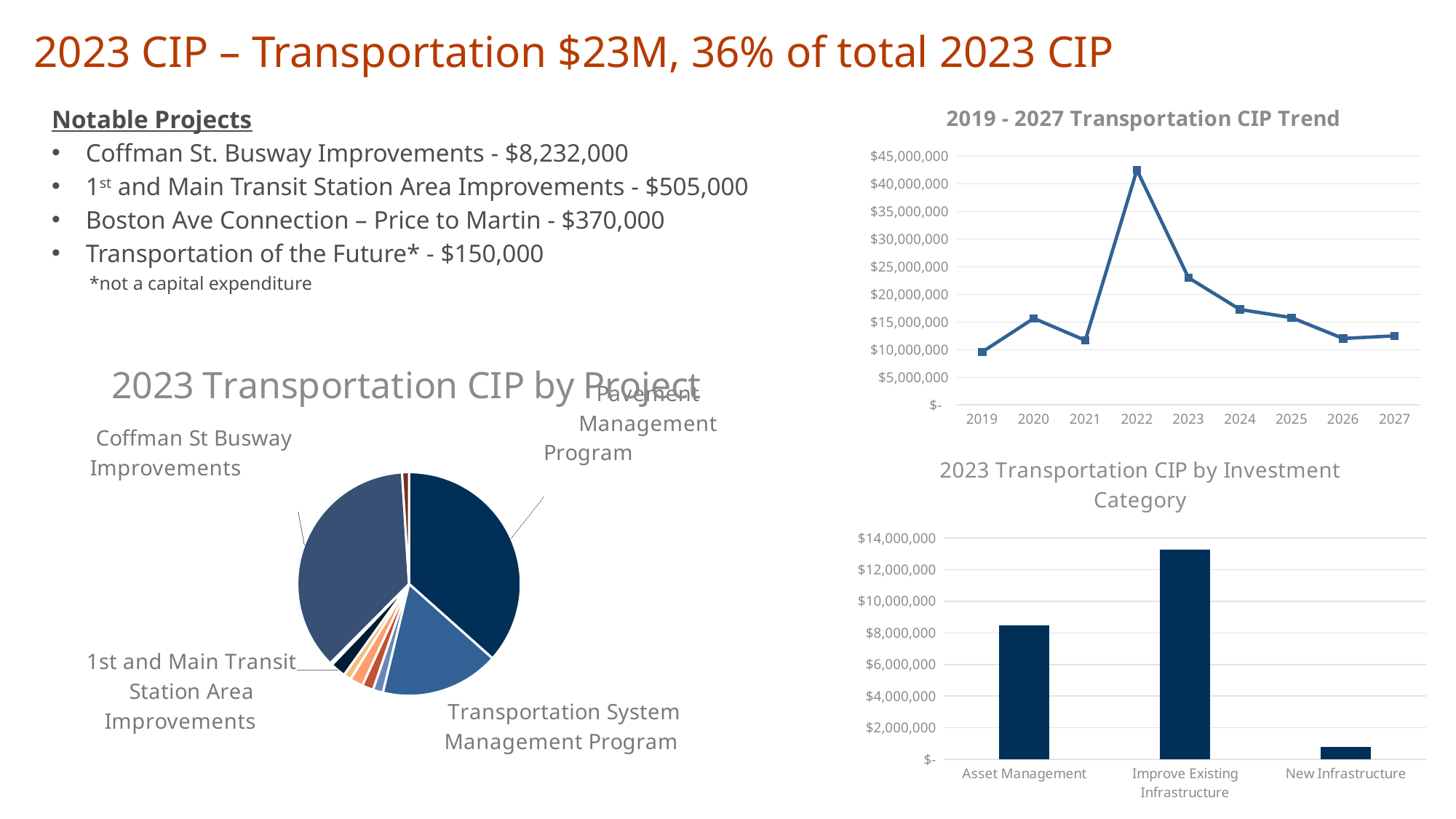
In the '2023 Transportation CIP by Project' pie chart, which slice is larger: Transportation System Management Program or 1st and Main Transit Station Area Improvements? Transportation System Management Program What kind of chart is the '2019 - 2027 Transportation CIP Trend' chart? line chart In the '2019 - 2027 Transportation CIP Trend' chart, do the values rise or fall from 2022 to 2026? fall In the '2019 - 2027 Transportation CIP Trend' chart, is the value for 2024 greater or less than $20,000,000? less What kind of chart is the '2023 Transportation CIP by Investment Category' chart? bar chart In the '2019 - 2027 Transportation CIP Trend' chart, how many years are plotted on the x axis? 9 In the '2023 Transportation CIP by Investment Category' chart, which category has the lowest value? New Infrastructure In the '2023 Transportation CIP by Investment Category' chart, which category has the highest value? Improve Existing Infrastructure In the '2019 - 2027 Transportation CIP Trend' chart, which year has the highest value? 2022 In the '2023 Transportation CIP by Investment Category' chart, is the value for Improve Existing Infrastructure greater or less than $12,000,000? greater In the '2019 - 2027 Transportation CIP Trend' chart, is the value for 2022 greater or less than $40,000,000? greater In the '2019 - 2027 Transportation CIP Trend' chart, which year has the lowest value? 2019